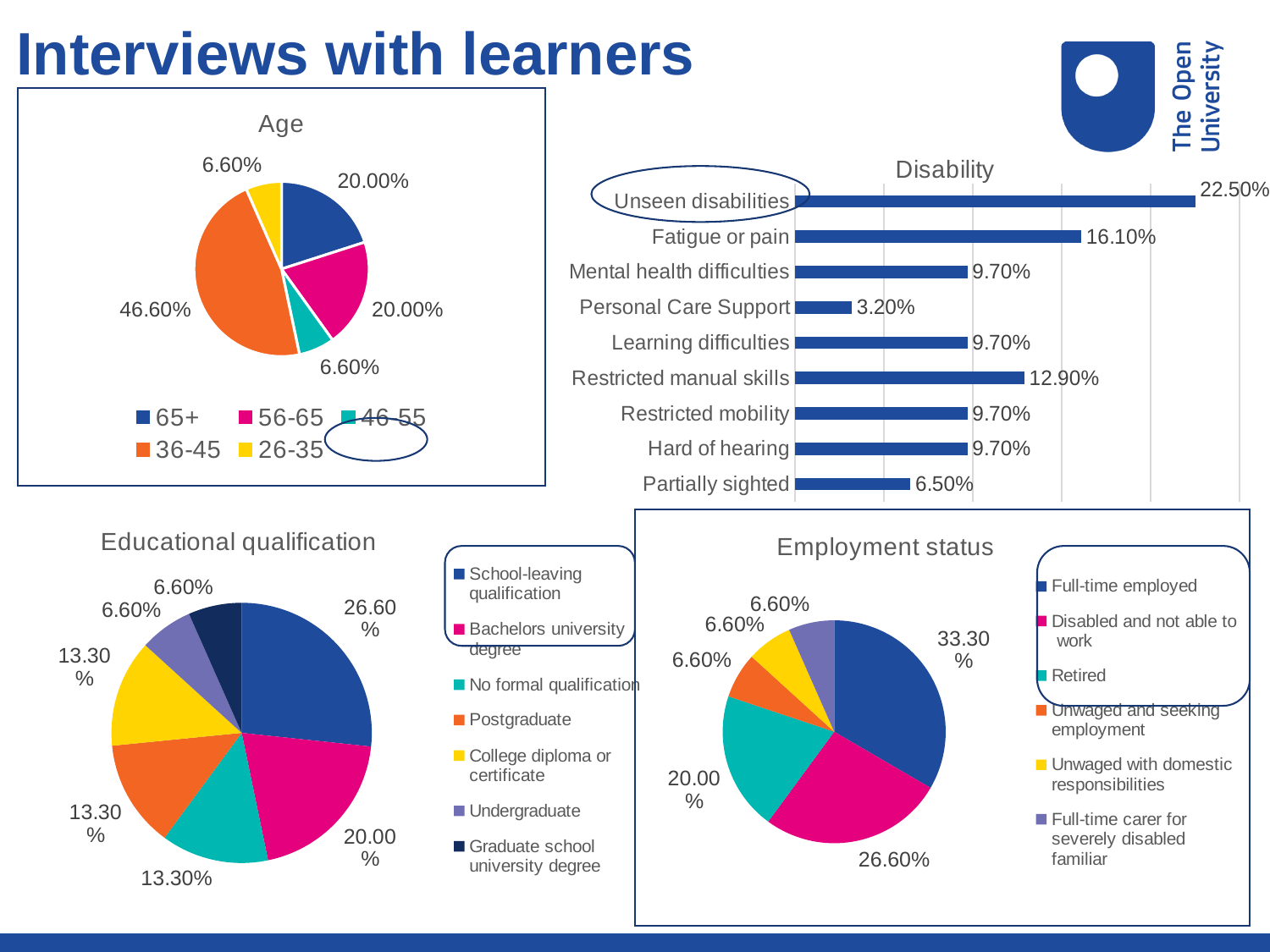
In the Educational qualification chart, what is the value for School-leaving qualification? 26.60% How many categories are shown in the Disability chart? 9 In the Age pie chart, what share does the 36-45 group have? 46.60% How many entries does the legend of the Employment status chart list? 6 In the Employment status chart, what is the value for Full-time employed? 33.30% In the Disability chart, what is the difference between Fatigue or pain and Restricted manual skills? 3.20% In the Age pie chart, which age group has the largest share? 36-45 In the Disability chart, which category has the lowest value? Personal Care Support How many entries does the legend of the Age chart list? 5 In the Educational qualification chart, which is larger: Bachelors university degree or Postgraduate? Bachelors university degree In the Disability chart, what is the value for Unseen disabilities? 22.50% What kind of chart is the Disability chart? Bar chart